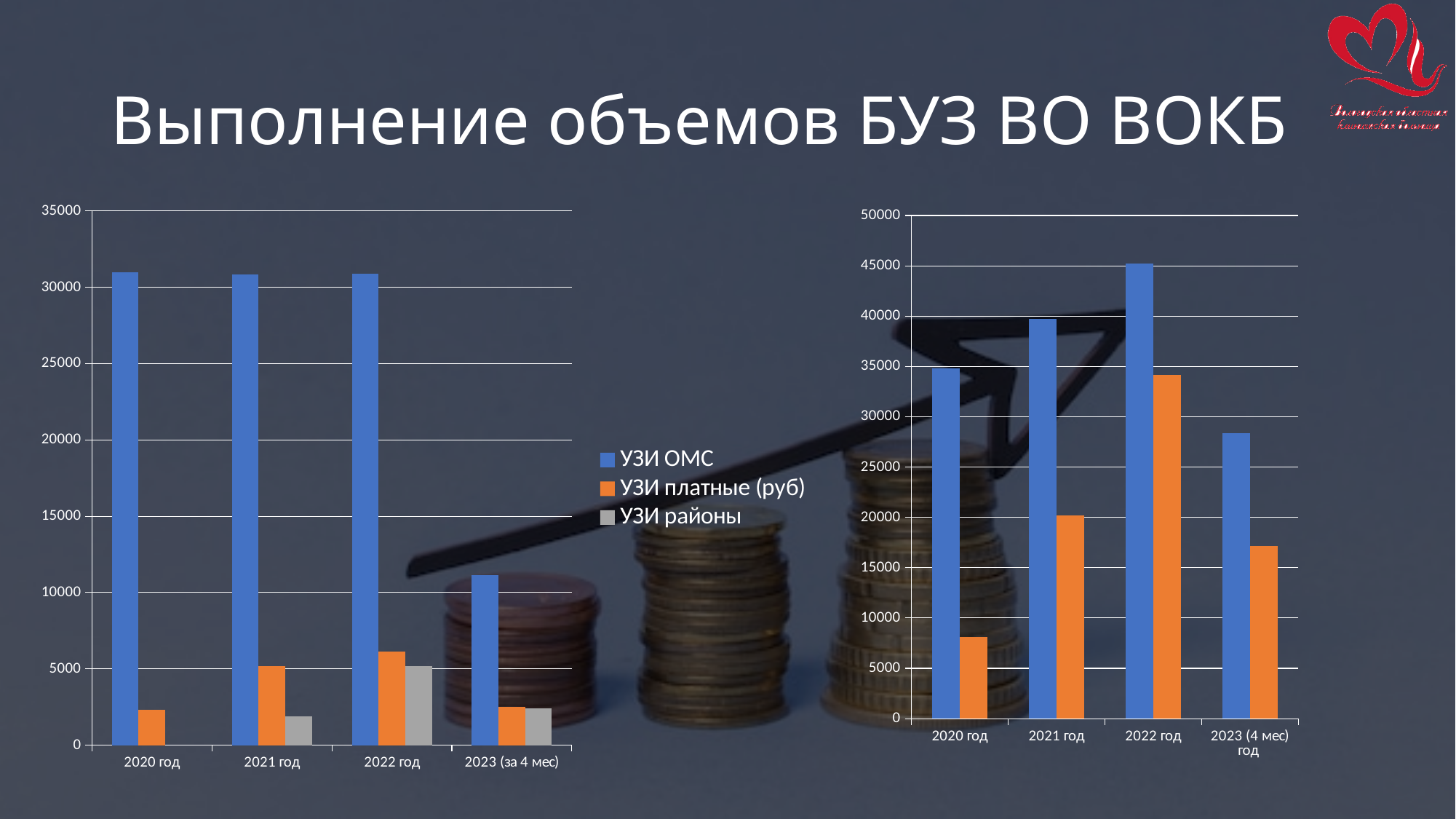
How many categories are shown on the x axis of the left chart? 4 In the right chart, which category has the highest blue bar? 2022 год In the left chart, is the value for УЗИ ОМС in 2023 (за 4 мес) greater or less than 10000? greater What kind of chart is the left chart on the slide? bar chart In the left chart, is the value for УЗИ платные (руб) in 2022 год greater or less than 5000? greater In the right chart, do the orange bars rise or fall from 2020 год to 2022 год? rise In the left chart, which category has the lowest value for УЗИ ОМС? 2023 (за 4 мес) In the right chart, is the orange bar for 2021 год greater or less than 25000? less How many series does the legend in the middle of the slide list? 3 In the right chart, which is larger, the blue bar for 2020 год or the blue bar for 2021 год? 2021 год